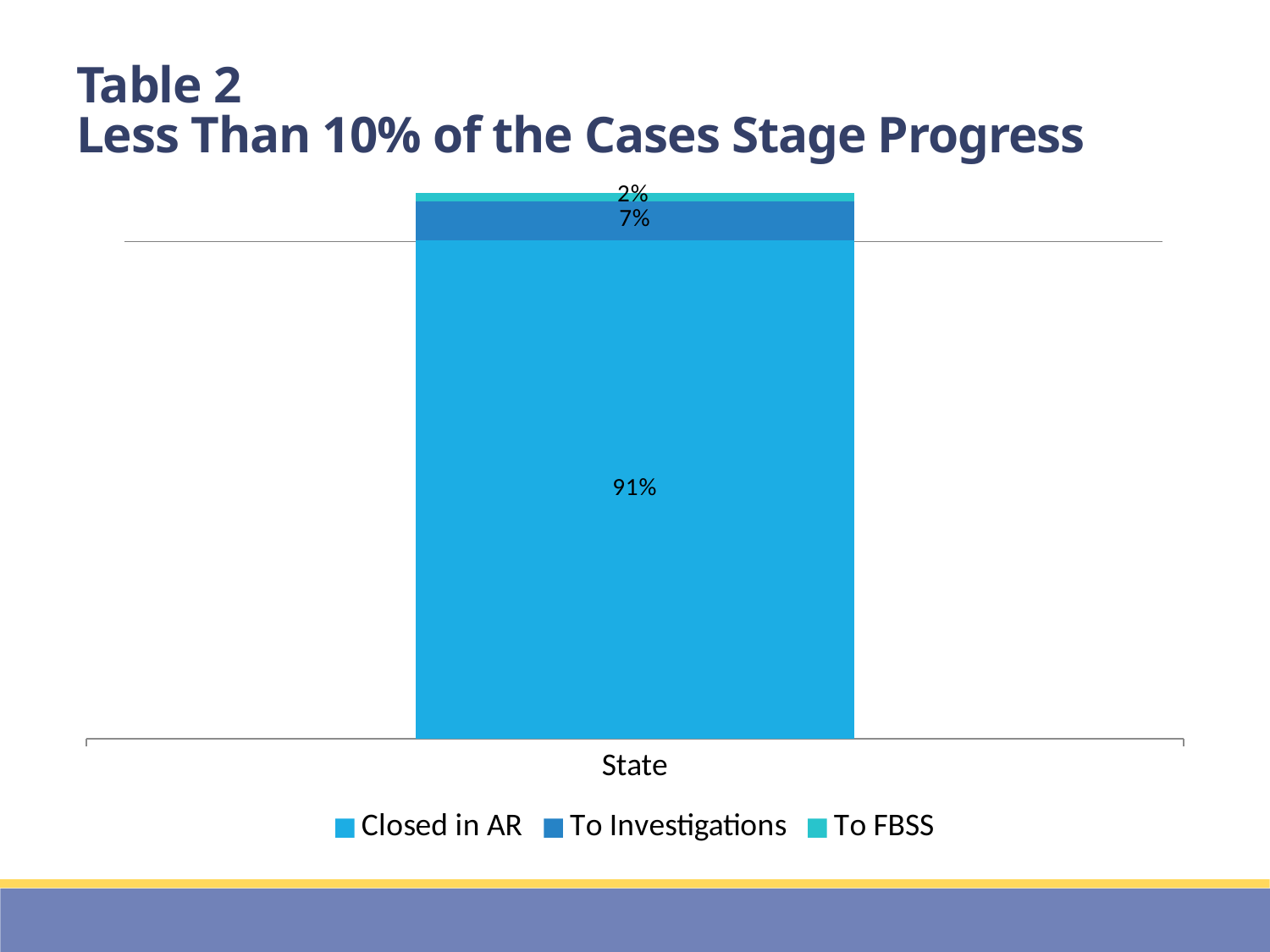
What is the total of the three segments in the State bar? 100% What is the difference between the Closed in AR and To Investigations percentages? 84% Which series has the smallest share of the State bar? To FBSS What percentage of cases were Closed in AR for State? 91% What percentage of cases went To FBSS for State? 2% Which series has the largest share of the State bar? Closed in AR Which is larger, To Investigations or To FBSS? To Investigations What kind of chart is shown on the slide? Stacked bar chart What percentage of cases went To Investigations for State? 7% What is the difference between the To Investigations and To FBSS percentages? 5% How many series does the legend list? 3 How many categories are shown on the x axis? 1